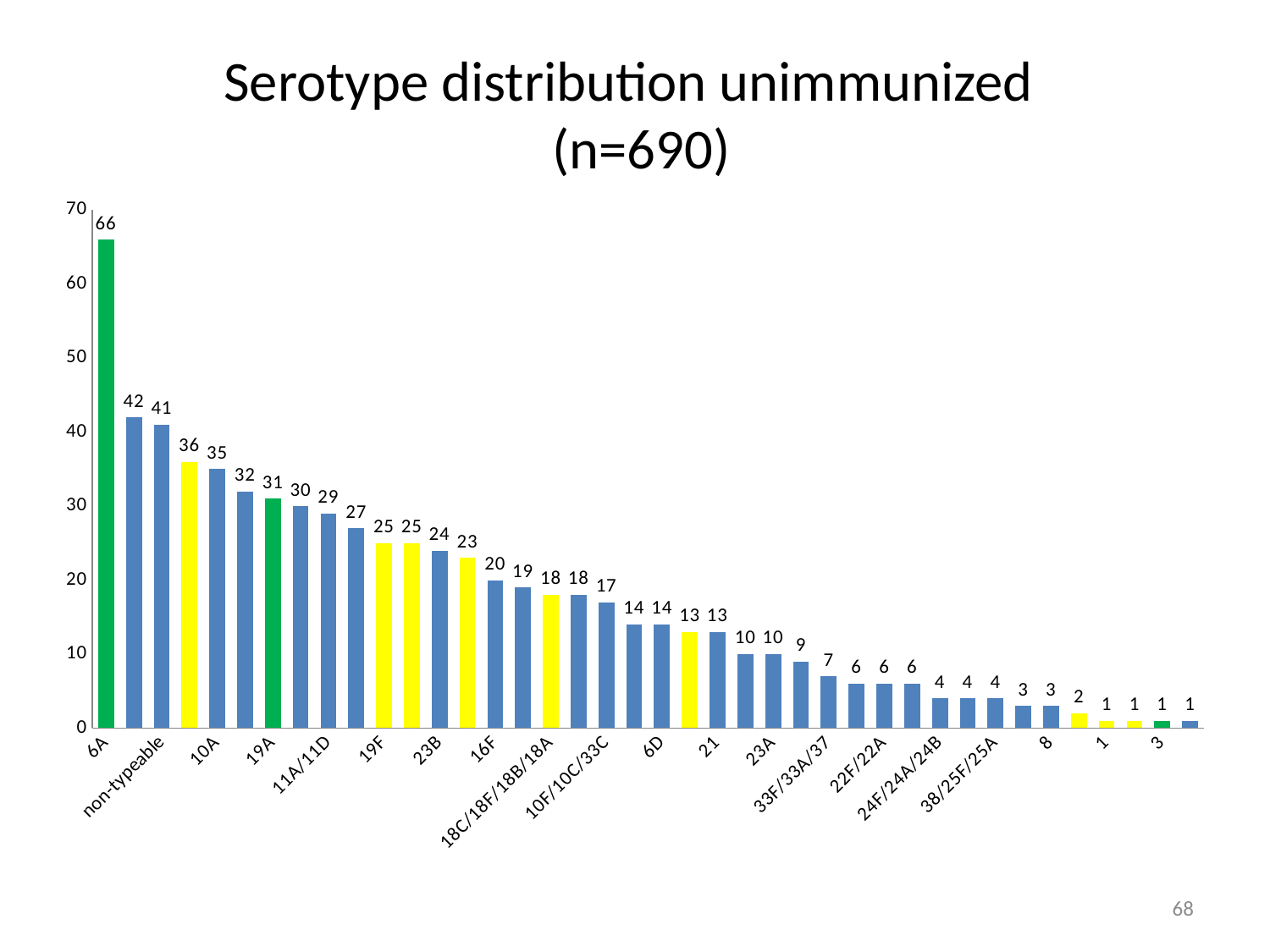
What is the value for 6A? 66 Which serotype has the highest value? 6A How many bars are plotted in the chart? 40 Do the values rise or fall from left to right along the x axis? Fall What is the value for 6D? 14 What is the value for non-typeable? 41 What is the value for 19F? 25 Which is larger, the value for 10A or the value for 19A? 10A What is the value for 19A? 31 What is the value for serotype 8? 3 What kind of chart is shown on the slide? Bar chart What is the difference between the values for 6A and non-typeable? 25